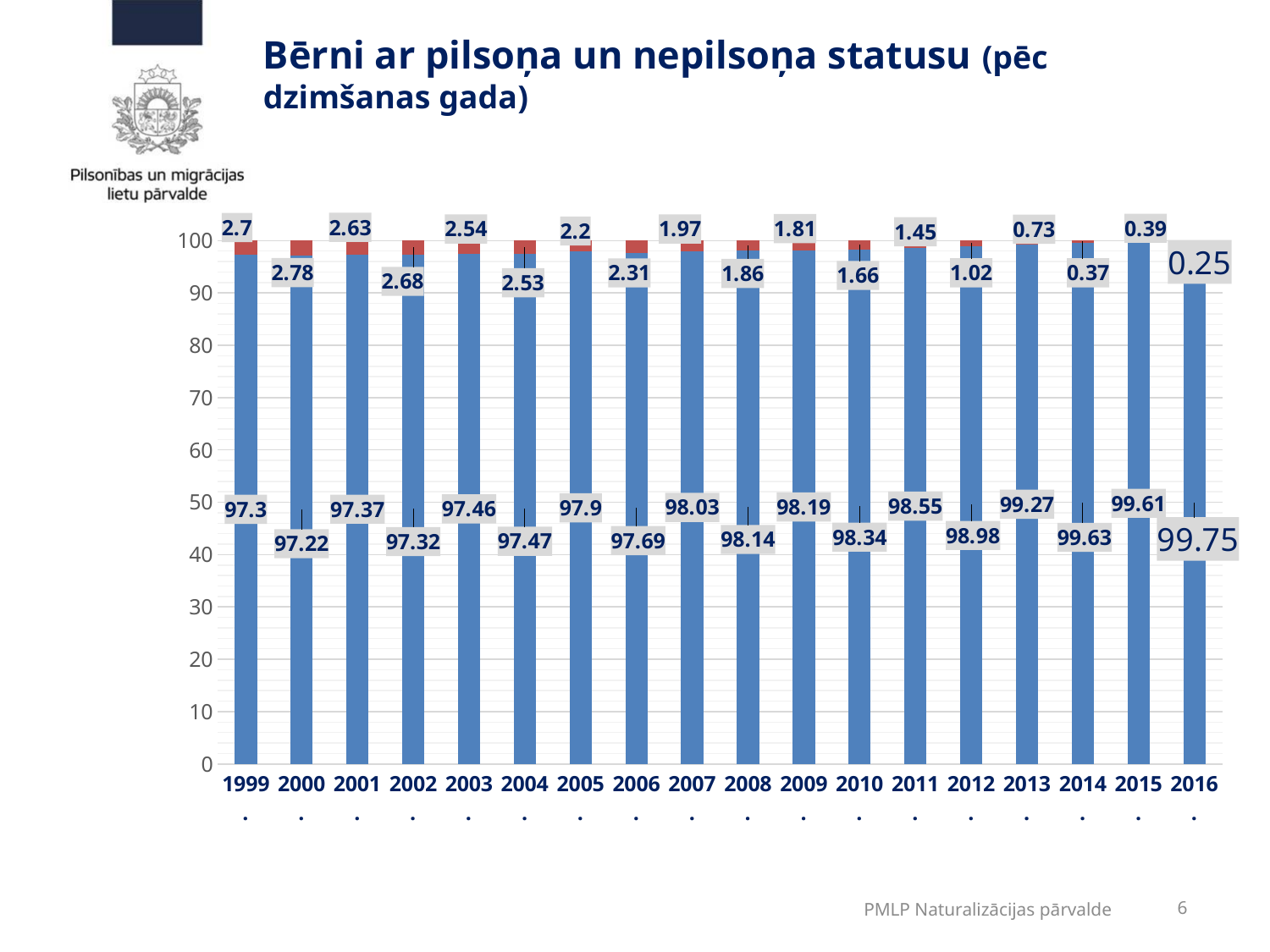
What is the value of the red segment for 2012? 1.02 Which year has the lowest value for the blue segment? 2000 What is the difference between the blue segment values for 2016 and 1999? 2.45 Do the values of the blue segment generally rise or fall from 1999 to 2016? rise What is the value of the red segment for 1999? 2.7 What kind of chart is shown on the slide? bar chart Which year has the highest value for the blue segment? 2016 How many years (categories) are shown on the x axis of the chart? 18 Which year has the highest value for the red segment? 2000 What is the total of the stacked bar for 1999? 100 What is the value of the blue segment for 2007? 98.03 What is the value of the blue segment for 2016? 99.75